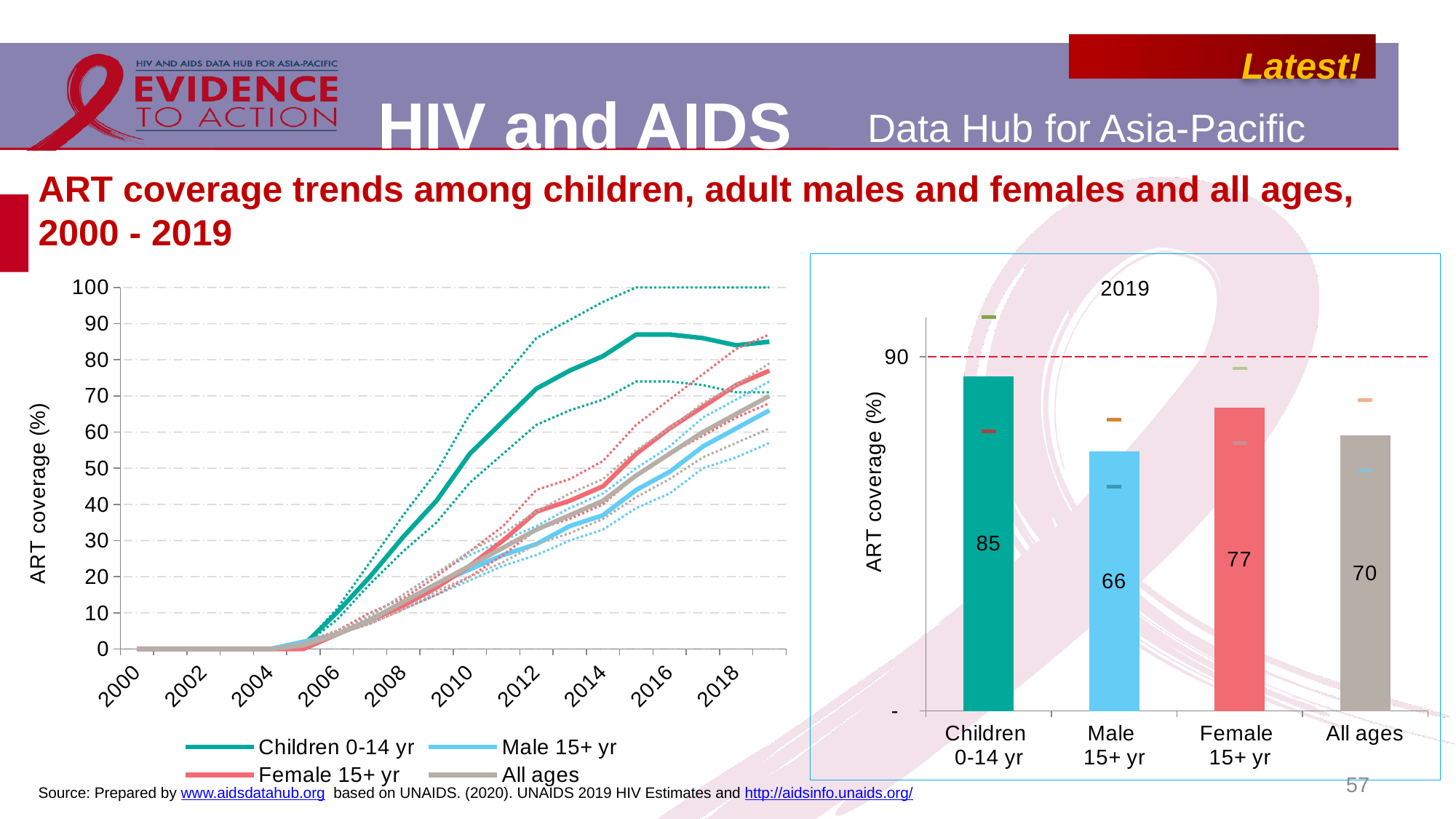
In the line chart on the left, does the ART coverage for Children 0-14 yr generally rise or fall from 2006 to 2016? Rise How many series does the legend of the line chart on the left list? 4 In the line chart on the left, is the value for Female 15+ yr in 2010 greater or less than 30? less How many categories are shown in the bar chart on the right (2019)? 4 In the bar chart on the right (2019), what is the difference between the ART coverage for Children 0-14 yr and Male 15+ yr? 19 In the bar chart on the right (2019), which is larger: the ART coverage for Female 15+ yr or Male 15+ yr? Female 15+ yr In the bar chart on the right (2019), which category has the highest ART coverage? Children 0-14 yr In the bar chart on the right (2019), which category has the lowest ART coverage? Male 15+ yr In the bar chart on the right (2019), what is the ART coverage for Children 0-14 yr? 85 In the bar chart on the right (2019), what is the ART coverage for All ages? 70 What kind of chart is the chart on the left showing trends from 2000 to 2019? Line chart In the bar chart on the right (2019), what is the ART coverage for Male 15+ yr? 66